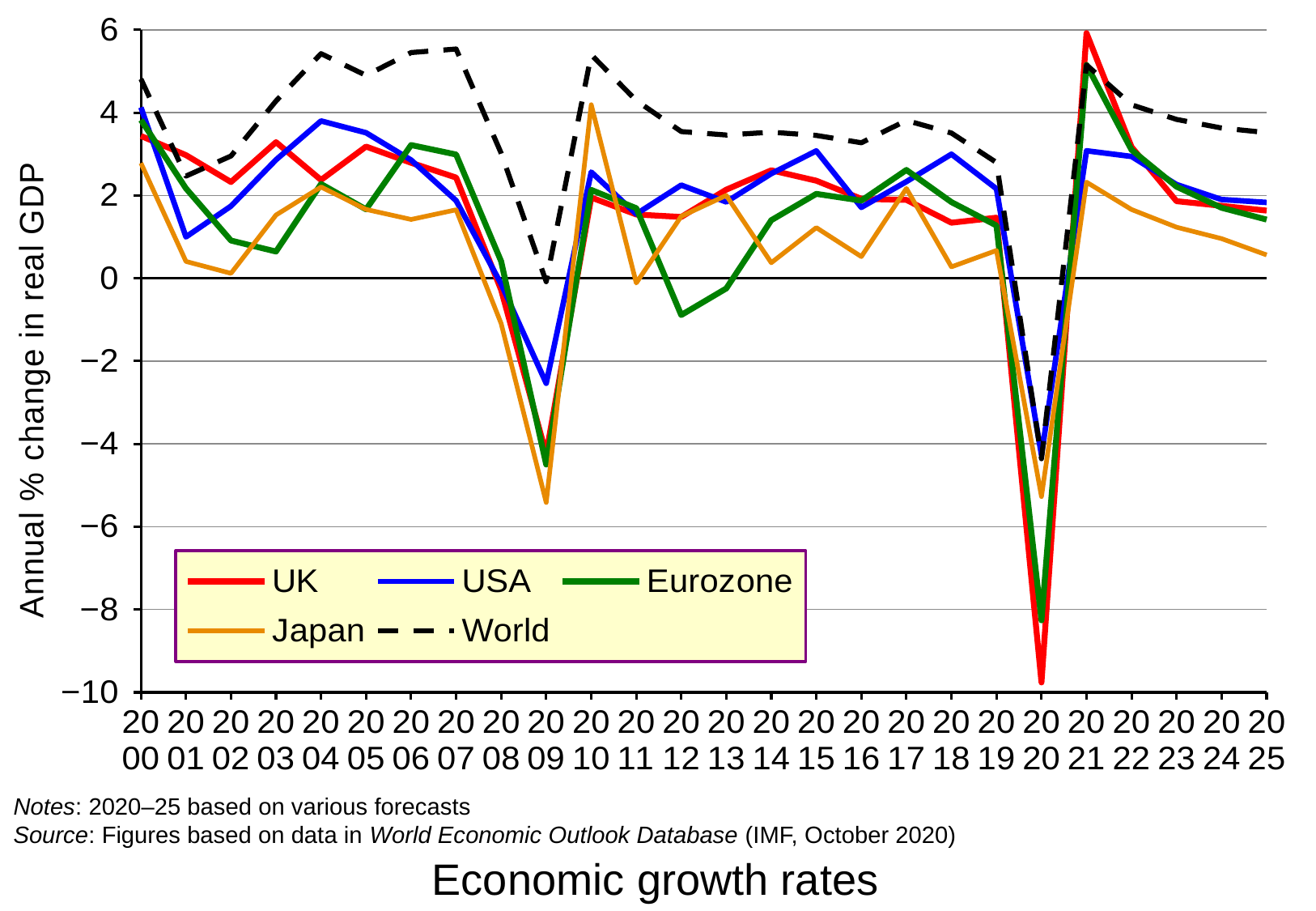
Which series has the lowest value in 2009? Japan Is the value for the UK in 2020 greater or less than -8? less What kind of chart is shown on the slide? line chart Is the value for Japan in 2009 greater or less than -4? less Which series has the lowest value in 2020? UK Which series is drawn with a dashed line? World How many series does the legend list? 5 Which series has the highest value in 2021? UK Does the World series rise or fall from 2021 to 2025? fall In 2009, which is lower, the value for Japan or the value for the USA? Japan How many years are plotted along the x axis? 26 Is the value for the World in 2004 greater or less than 4? greater